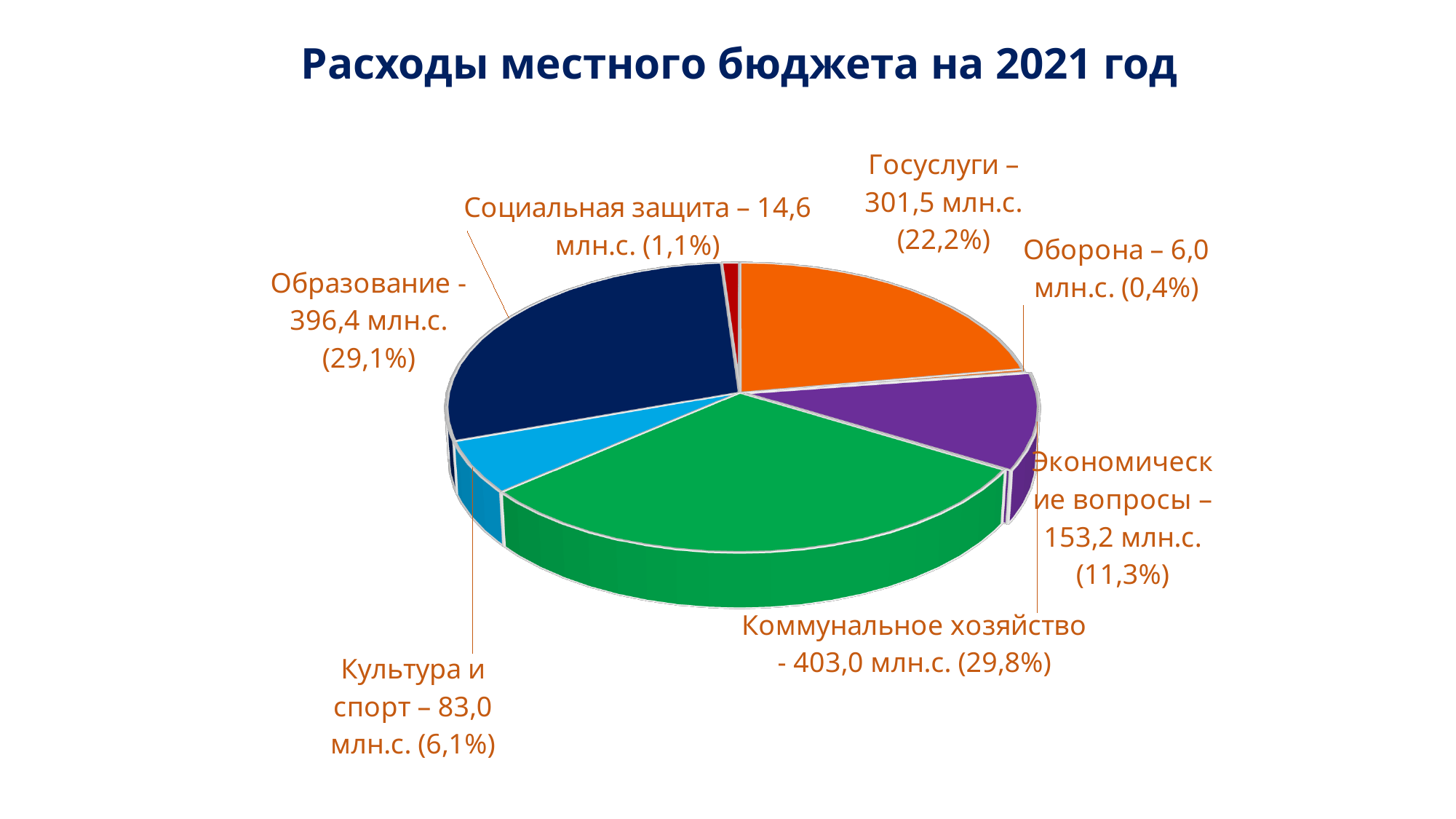
What is the title of the chart? Расходы местного бюджета на 2021 год What is the difference between Коммунальное хозяйство and Образование? 6,6 млн.с. What share of the pie does Госуслуги represent? 22,2% What is the value for Экономические вопросы? 153,2 млн.с. Which category has the smallest share of the budget? Оборона What is the value for Образование? 396,4 млн.с. How many slices does the pie chart have? 7 What share of the pie does Культура и спорт represent? 6,1% What type of chart is shown on the slide? Pie chart Which category has the largest share of the budget? Коммунальное хозяйство What is the difference between Культура и спорт and Социальная защита? 68,4 млн.с. Which is larger: Госуслуги or Экономические вопросы? Госуслуги